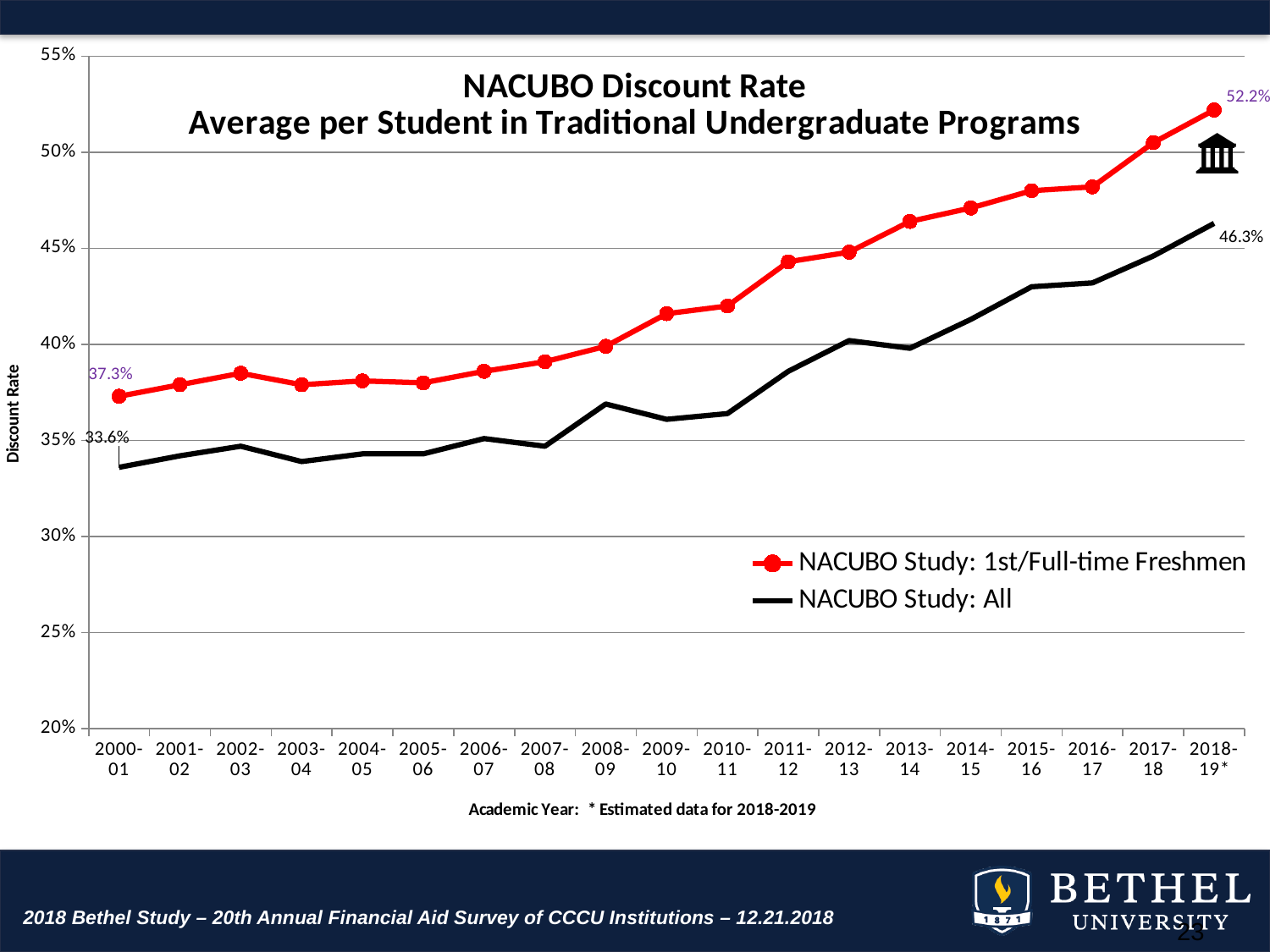
Is the NACUBO Study: All discount rate for 2015-16 greater or less than 40%? greater How many academic years are plotted along the x axis? 19 By how much did the NACUBO Study: All discount rate change from 2000-01 to 2018-19? 12.7% Do the discount rates generally rise or fall from 2000-01 to 2018-19? rise What is the NACUBO Study: All discount rate for 2000-01? 33.6% What is the difference between the 1st/Full-time Freshmen and All discount rates in 2018-19? 5.9% How many series does the legend list? 2 Which series has the higher discount rate in 2012-13, 1st/Full-time Freshmen or All? NACUBO Study: 1st/Full-time Freshmen What is the NACUBO Study: 1st/Full-time Freshmen discount rate for 2018-19? 52.2% What type of chart is shown on the slide? line chart What is the NACUBO Study: All discount rate for 2018-19? 46.3% What is the NACUBO Study: 1st/Full-time Freshmen discount rate for 2000-01? 37.3%